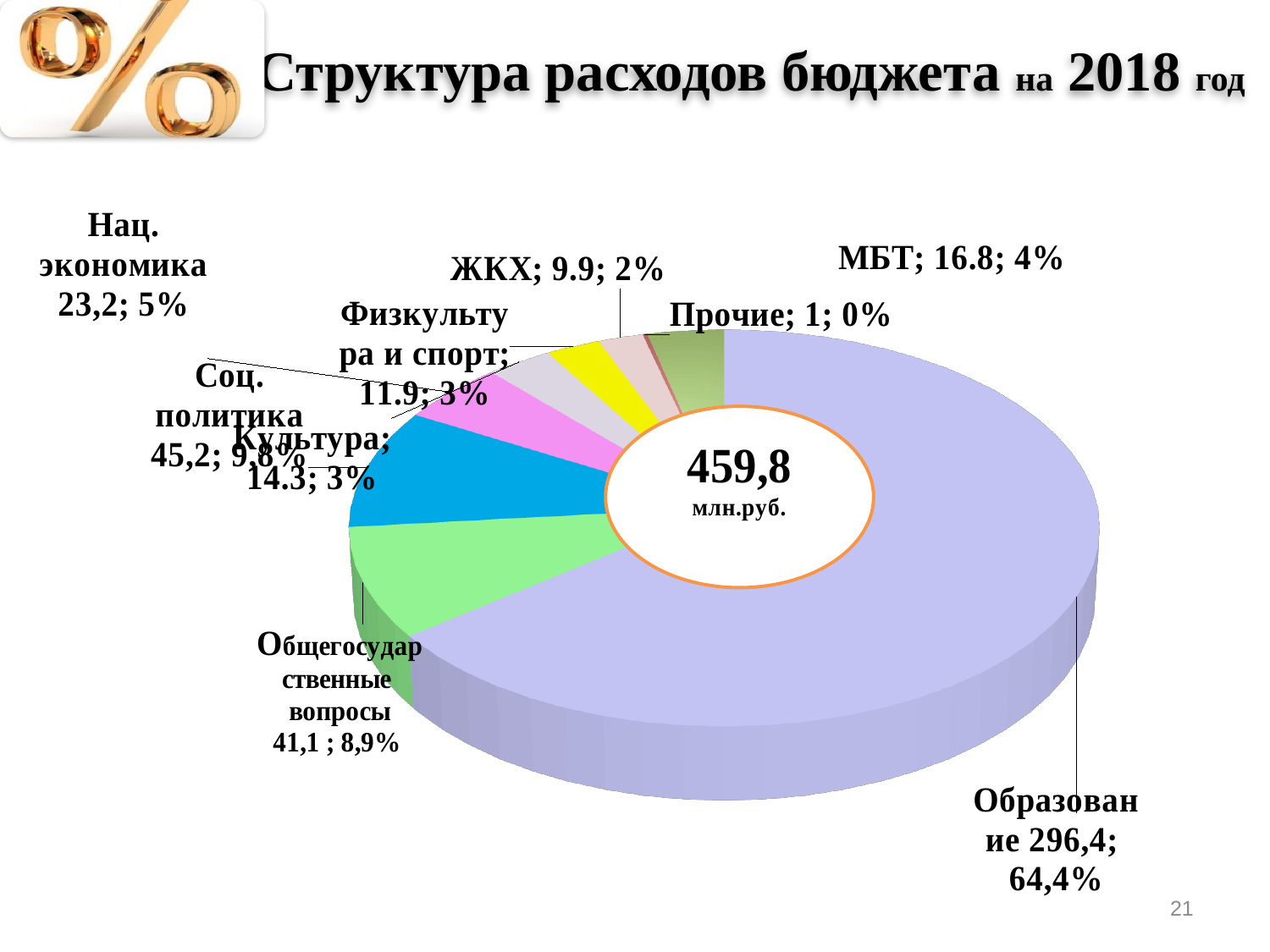
What kind of chart is shown on the slide? Pie chart What is the difference between the values for МБТ and ЖКХ? 6.9 What is the value shown for МБТ? 16.8 Which category has the smallest slice of the pie? Прочие Which is larger, the value for Соц. политика or for Общегосударственные вопросы? Соц. политика What is the value shown for Образование? 296,4 What share of the pie does Образование take? 64,4% What share of the pie does Нац. экономика take? 5% Which category has the largest slice of the pie? Образование What is the value shown for Соц. политика? 45,2 How many categories are shown in the pie chart? 9 What share of the pie does Общегосударственные вопросы take? 8,9%